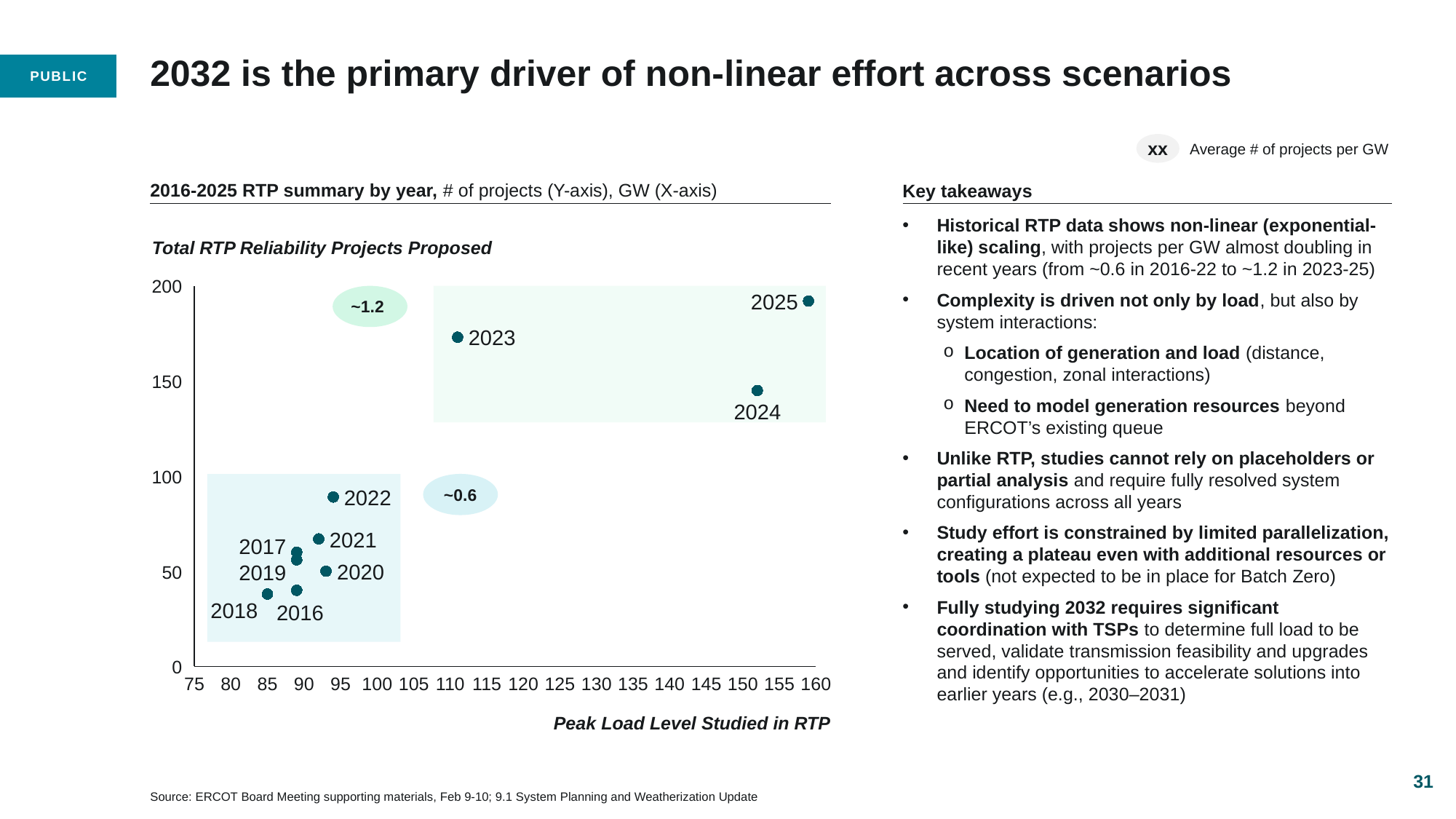
Which year has more projects proposed, 2023 or 2024? 2023 What kind of chart is shown on the slide? Scatter chart Which year has more projects proposed, 2022 or 2021? 2022 Which year is plotted at the lowest Peak Load Level Studied in RTP (furthest left on the x-axis)? 2018 Is the number of projects for 2022 greater or less than 100? less Which year is plotted at the highest Peak Load Level Studied in RTP (furthest right on the x-axis)? 2025 Is the number of projects for 2024 greater or less than 150? less How many data points (years) are plotted on the chart? 10 Which year has the highest number of Total RTP Reliability Projects Proposed? 2025 Is the number of projects for 2023 greater or less than 150? greater Do the number of projects generally rise or fall as the peak load level increases along the x-axis? Rise What is the title of the x-axis of the chart? Peak Load Level Studied in RTP